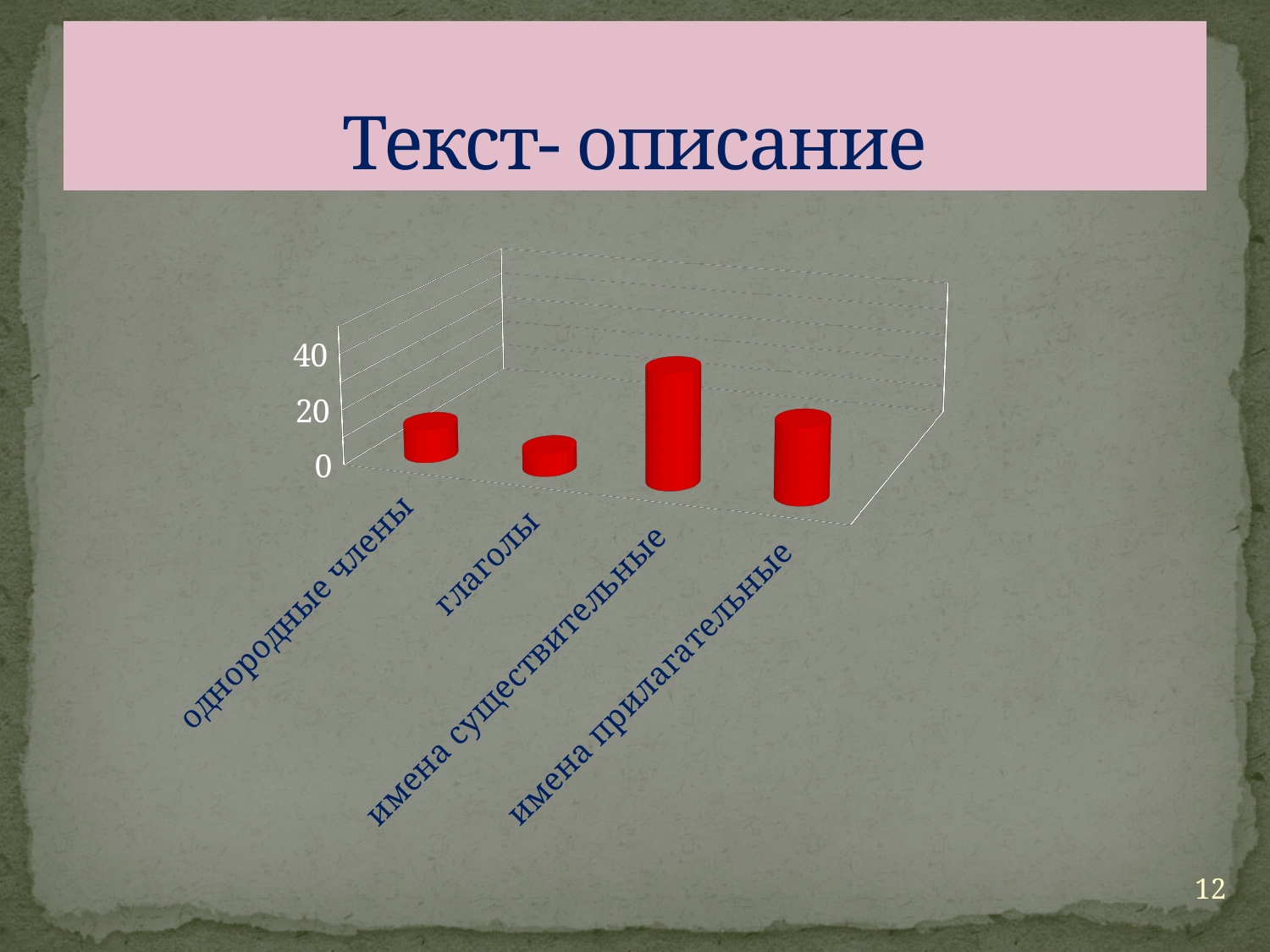
Which category has the highest bar? имена существительные Is the value for имена существительные greater or less than 20? greater Which is larger, the value for однородные члены or for глаголы? однородные члены Which is larger, the value for имена существительные or for имена прилагательные? имена существительные Is the value for глаголы greater or less than 20? less Which category has the lowest bar? глаголы Is the value for однородные члены greater or less than 20? less How many categories are plotted in the chart? 4 What kind of chart is shown on the slide? bar chart What colour are the bars in the chart? red What is the title shown at the top of the slide? Текст- описание